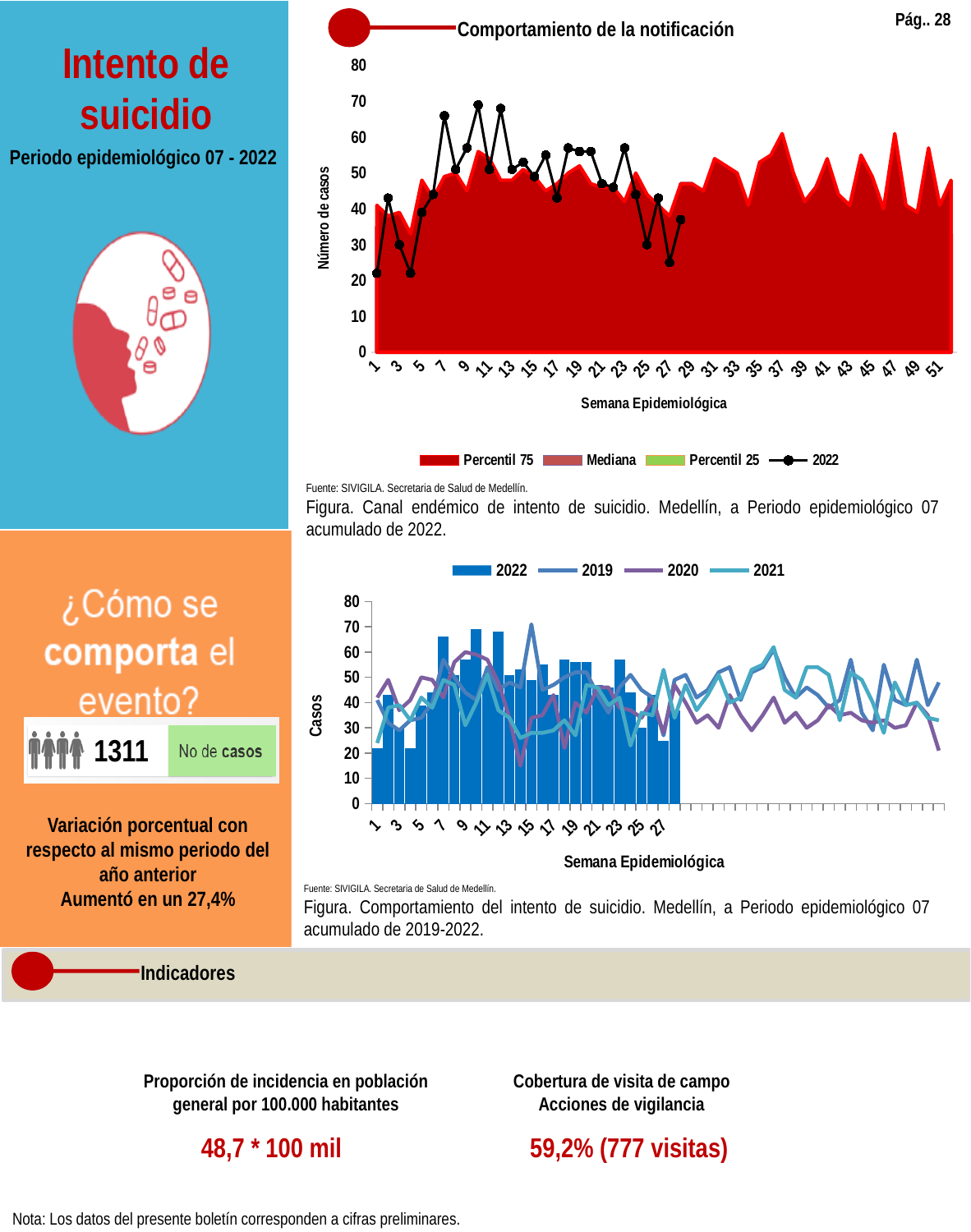
In the top chart 'Comportamiento de la notificación', what are the legend entries? Percentil 75, Mediana, Percentil 25, 2022 In the top chart 'Comportamiento de la notificación', what is the title of the vertical axis? Número de casos In the bottom chart (Comportamiento del intento de suicidio 2019-2022), what is the highest value shown on the vertical axis? 80 In the bottom chart (Comportamiento del intento de suicidio 2019-2022), is the 2022 value for week 4 greater or less than 30? less In the top chart 'Comportamiento de la notificación', is the 2022 value for week 10 greater or less than 60? greater In the bottom chart (Comportamiento del intento de suicidio 2019-2022), which series is drawn as bars rather than a line? 2022 In the bottom chart (Comportamiento del intento de suicidio 2019-2022), how many series does the legend list? 4 In the top chart 'Comportamiento de la notificación', is the 2022 value for week 28 greater or less than 30? greater In the top chart 'Comportamiento de la notificación', how many entries does the legend list? 4 In the bottom chart (Comportamiento del intento de suicidio 2019-2022), which is larger for 2022: the value for week 10 or the value for week 1? week 10